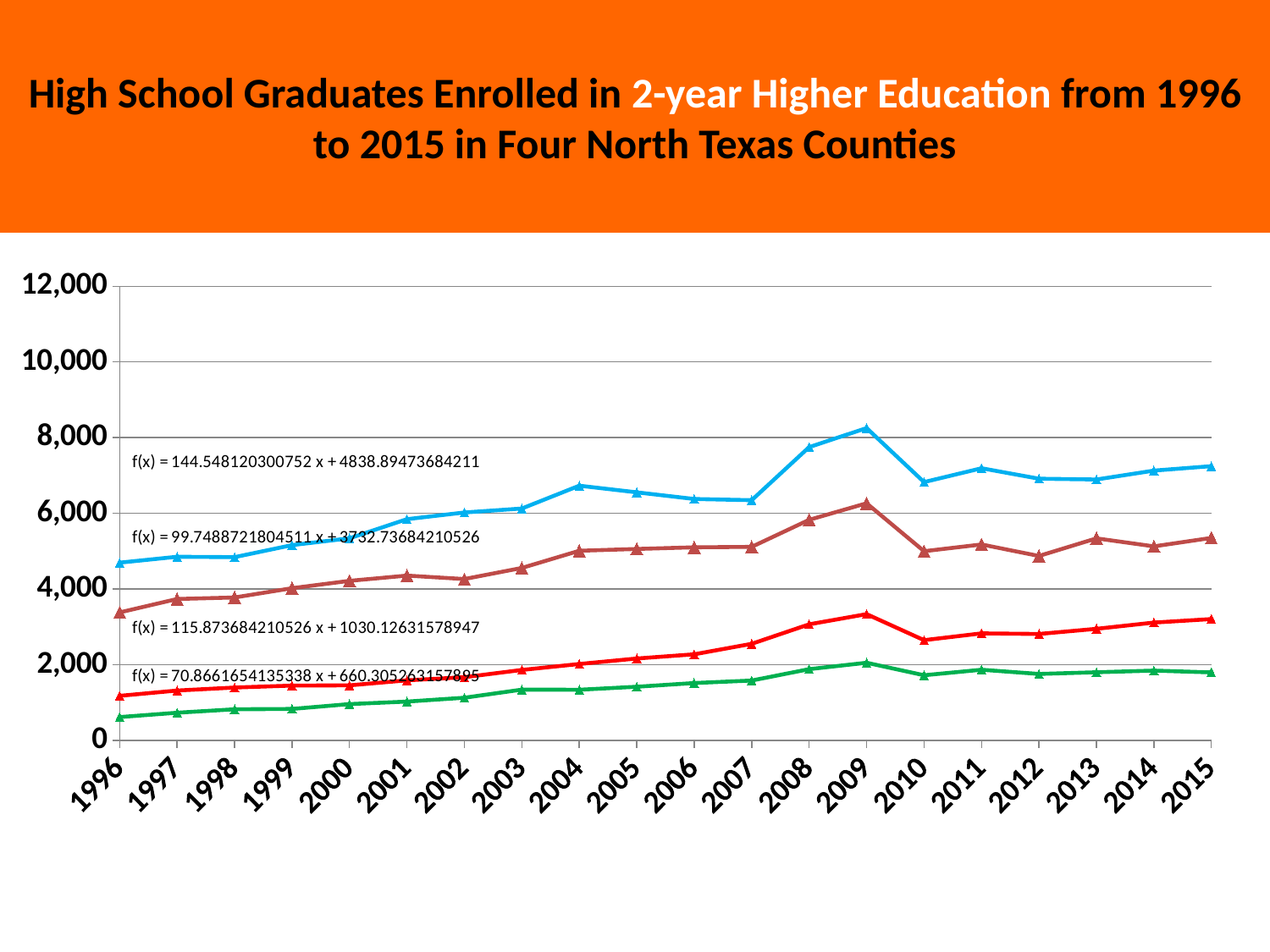
Which line is the lowest across all years on the chart? the green line What kind of chart is shown on the slide? line chart Is the value of the red line in 2009 greater or less than 4,000? less How many lines are plotted on the chart? 4 Which is larger for the blue line: the value in 2009 or the value in 2010? 2009 Does the red line generally rise or fall from 1996 to 2015? rise Is the value of the brown line in 1996 greater or less than 4,000? less Is the value of the blue line in 1996 greater or less than 4,000? greater In which year does the blue line reach its highest value? 2009 What is the highest value shown on the y axis of the chart? 12,000 How many years are plotted along the x axis of the chart? 20